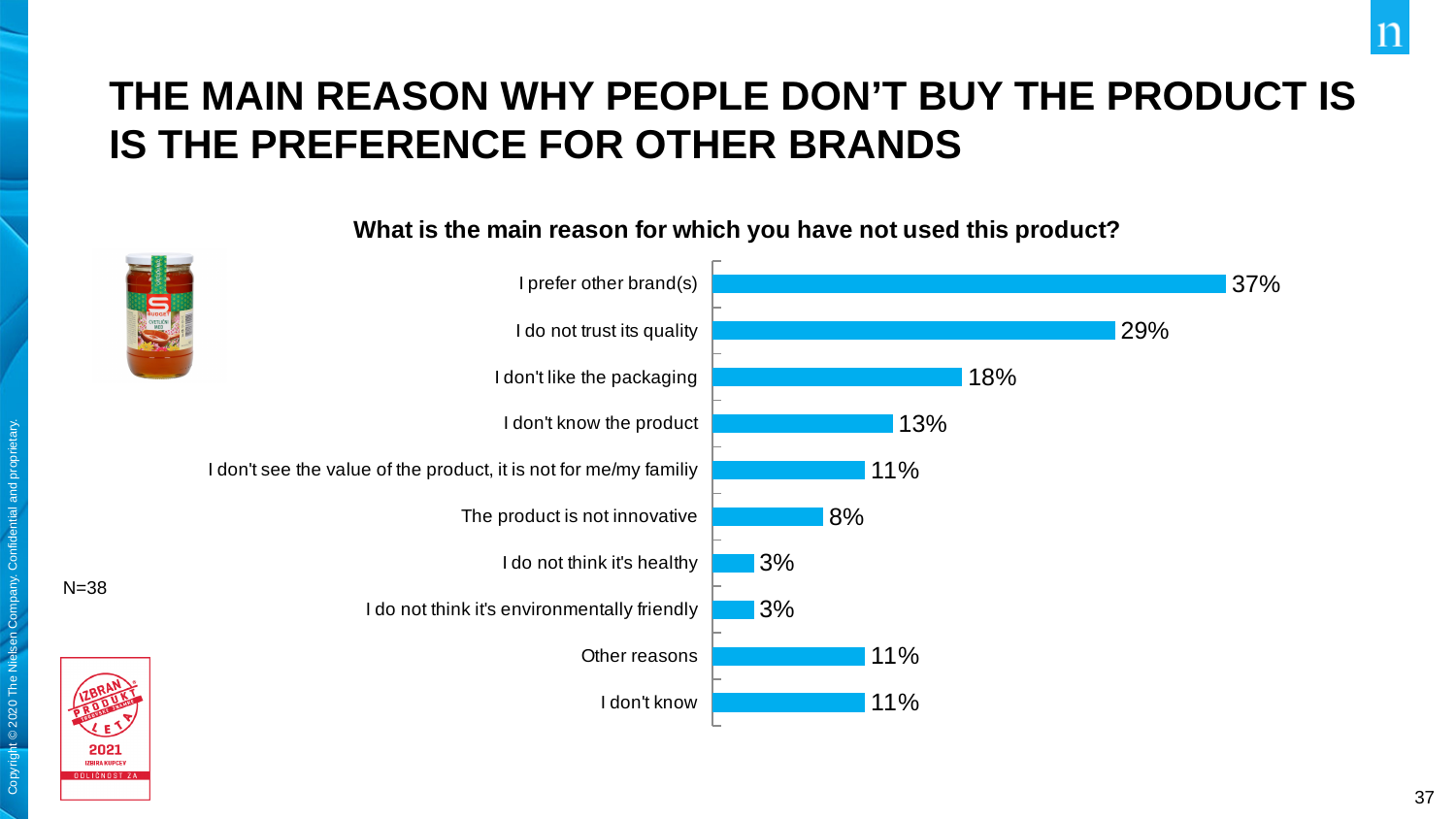
What is the difference between "I prefer other brand(s)" and "I do not trust its quality"? 8 percentage points What type of chart is shown on the slide? Bar chart Which is larger: "I don't know the product" or "The product is not innovative"? I don't know the product What is the lowest value shown in the chart? 3% How many reasons (categories) are shown in the chart? 10 What percentage of respondents said "I prefer other brand(s)"? 37% What is the value for "I do not trust its quality"? 29% What is the value for "The product is not innovative"? 8% What question is the chart based on, as shown in its title? What is the main reason for which you have not used this product? What is the sample size (N) stated on the slide? N=38 What percentage chose "I don't like the packaging"? 18% Which reason has the highest percentage? I prefer other brand(s)